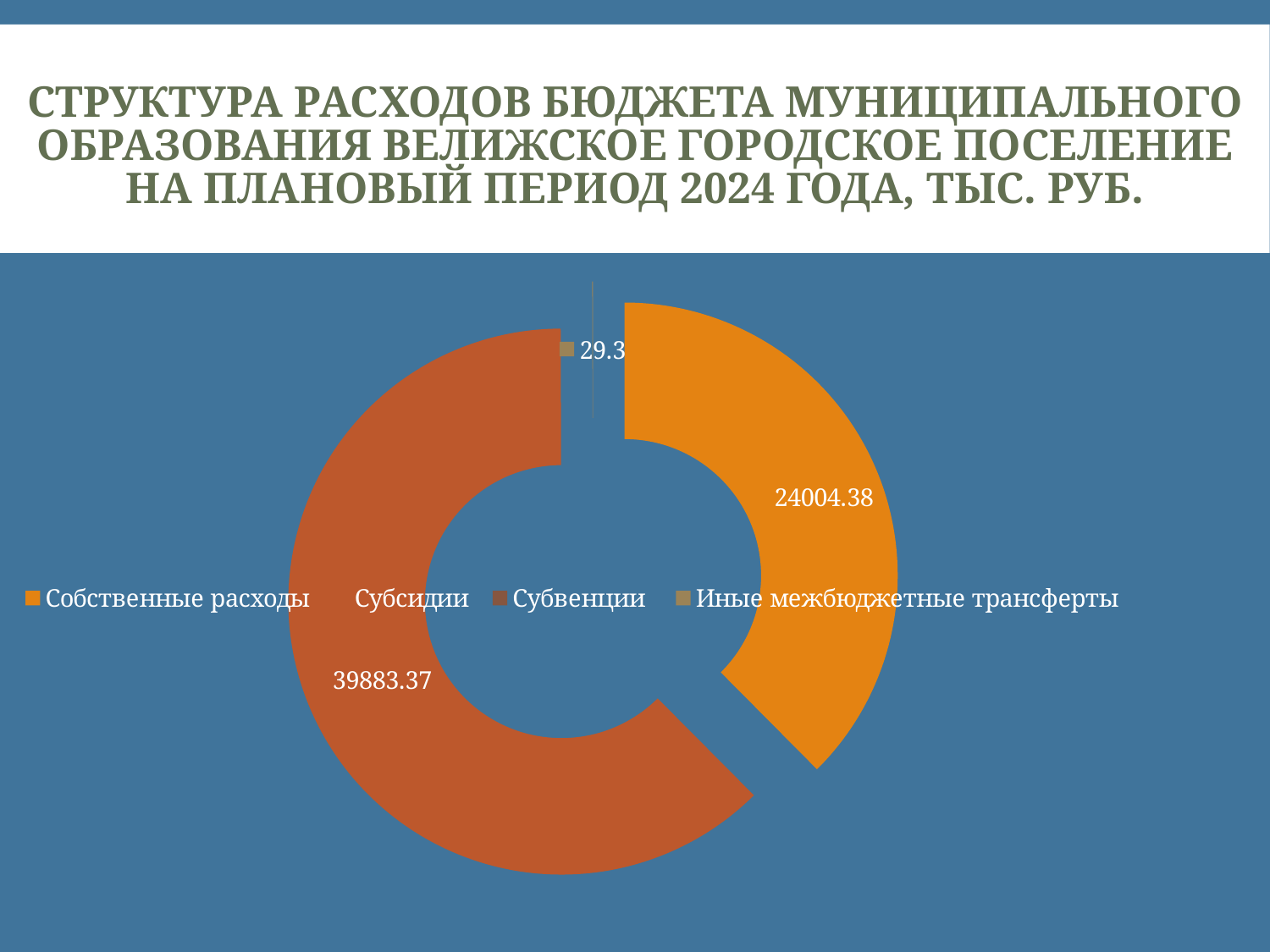
What kind of chart is shown on the slide? doughnut chart What colour is the slice for Собственные расходы? orange What is the value for Собственные расходы? 24004.38 What is the difference between Собственные расходы and Иные межбюджетные трансферты? 23975.08 What unit is stated in the slide title for the values? тыс. руб. Which category has the largest value? Субсидии How many entries does the legend list? 4 What is the value for Иные межбюджетные трансферты? 29.3 Which is larger, Собственные расходы or Иные межбюджетные трансферты? Собственные расходы